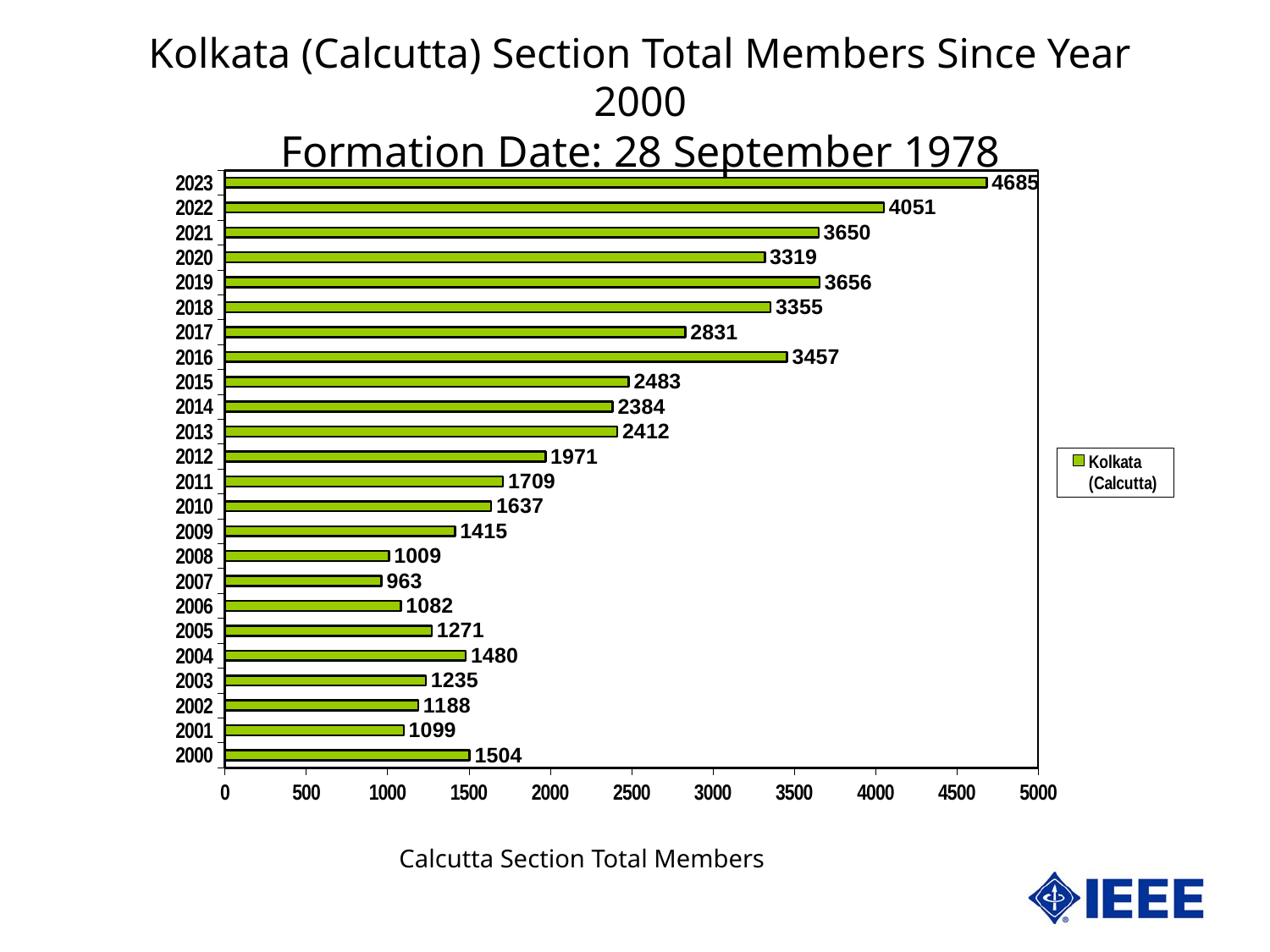
Which year has more members, 2019 or 2020? 2019 Which year has the lowest number of members? 2007 Is the value for 2017 greater or less than 3000? less Which year has the highest number of members? 2023 What kind of chart is shown on the slide? bar chart What is the total number of members for 2000? 1504 What is the legend entry for the series shown? Kolkata (Calcutta) What is the total number of members for 2023? 4685 How many series does the legend list? 1 What is the difference in members between 2023 and 2022? 634 What is the value shown for 2016? 3457 How many years are shown on the chart? 24